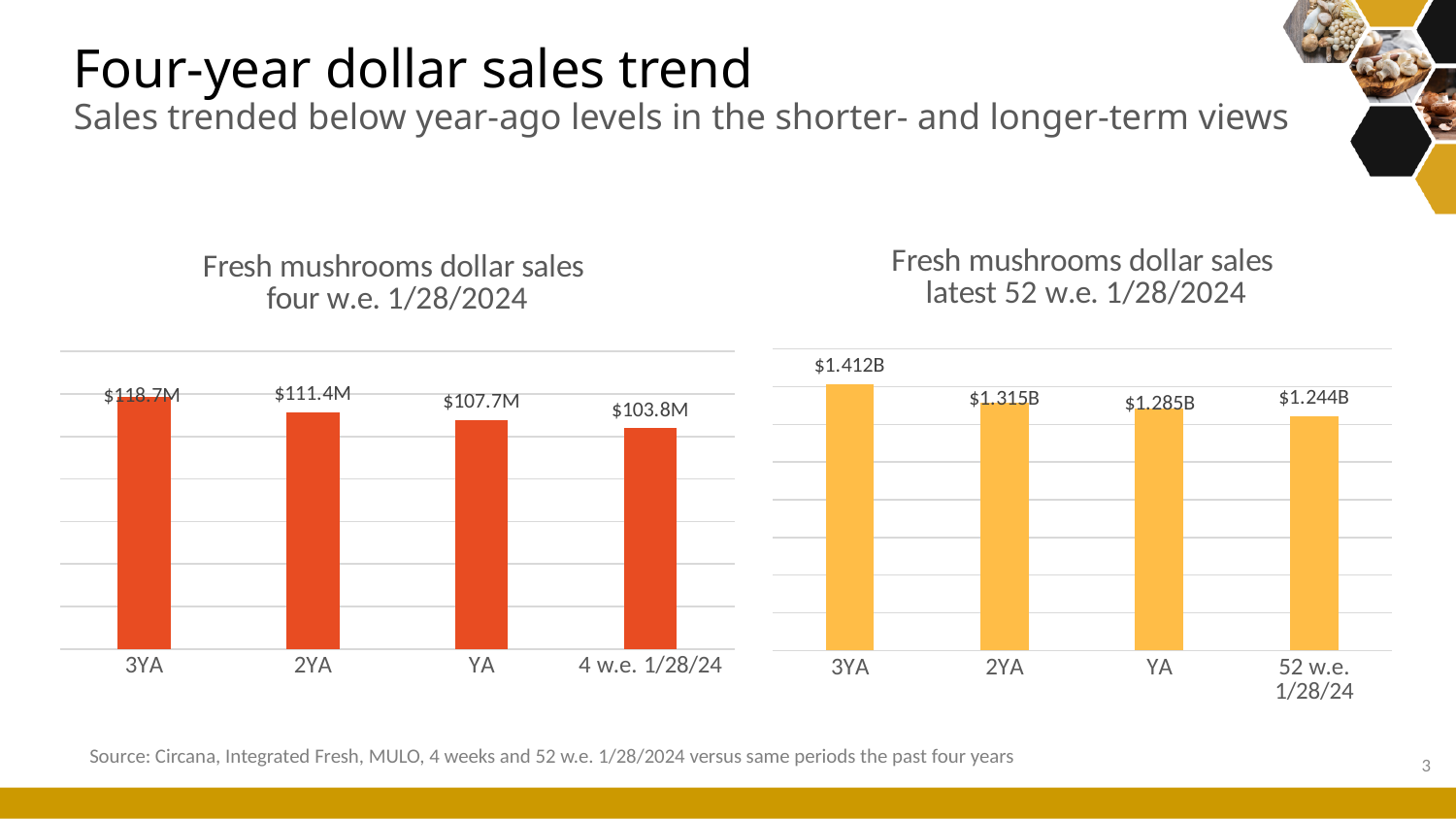
In the 'Fresh mushrooms dollar sales four w.e. 1/28/2024' chart, what is the value for 4 w.e. 1/28/24? $103.8M In the 'Fresh mushrooms dollar sales latest 52 w.e. 1/28/2024' chart, what is the value for 2YA? $1.315B What kind of chart is the 'Fresh mushrooms dollar sales four w.e. 1/28/2024' chart? Bar chart In the 'Fresh mushrooms dollar sales four w.e. 1/28/2024' chart, what is the value for 3YA? $118.7M In the 'Fresh mushrooms dollar sales latest 52 w.e. 1/28/2024' chart, what is the value for YA? $1.285B In the 'Fresh mushrooms dollar sales four w.e. 1/28/2024' chart, which period has the highest value? 3YA How many bars are in the 'Fresh mushrooms dollar sales latest 52 w.e. 1/28/2024' chart? 4 In the 'Fresh mushrooms dollar sales four w.e. 1/28/2024' chart, which is larger: the value for YA or the value for 4 w.e. 1/28/24? YA In the 'Fresh mushrooms dollar sales latest 52 w.e. 1/28/2024' chart, what is the difference between the 3YA and 52 w.e. 1/28/24 values? $0.168B In the 'Fresh mushrooms dollar sales latest 52 w.e. 1/28/2024' chart, which period has the lowest value? 52 w.e. 1/28/24 In the 'Fresh mushrooms dollar sales four w.e. 1/28/2024' chart, what is the difference between the 2YA and YA values? $3.7M In the 'Fresh mushrooms dollar sales latest 52 w.e. 1/28/2024' chart, do the values rise or fall from 3YA to 52 w.e. 1/28/24? Fall